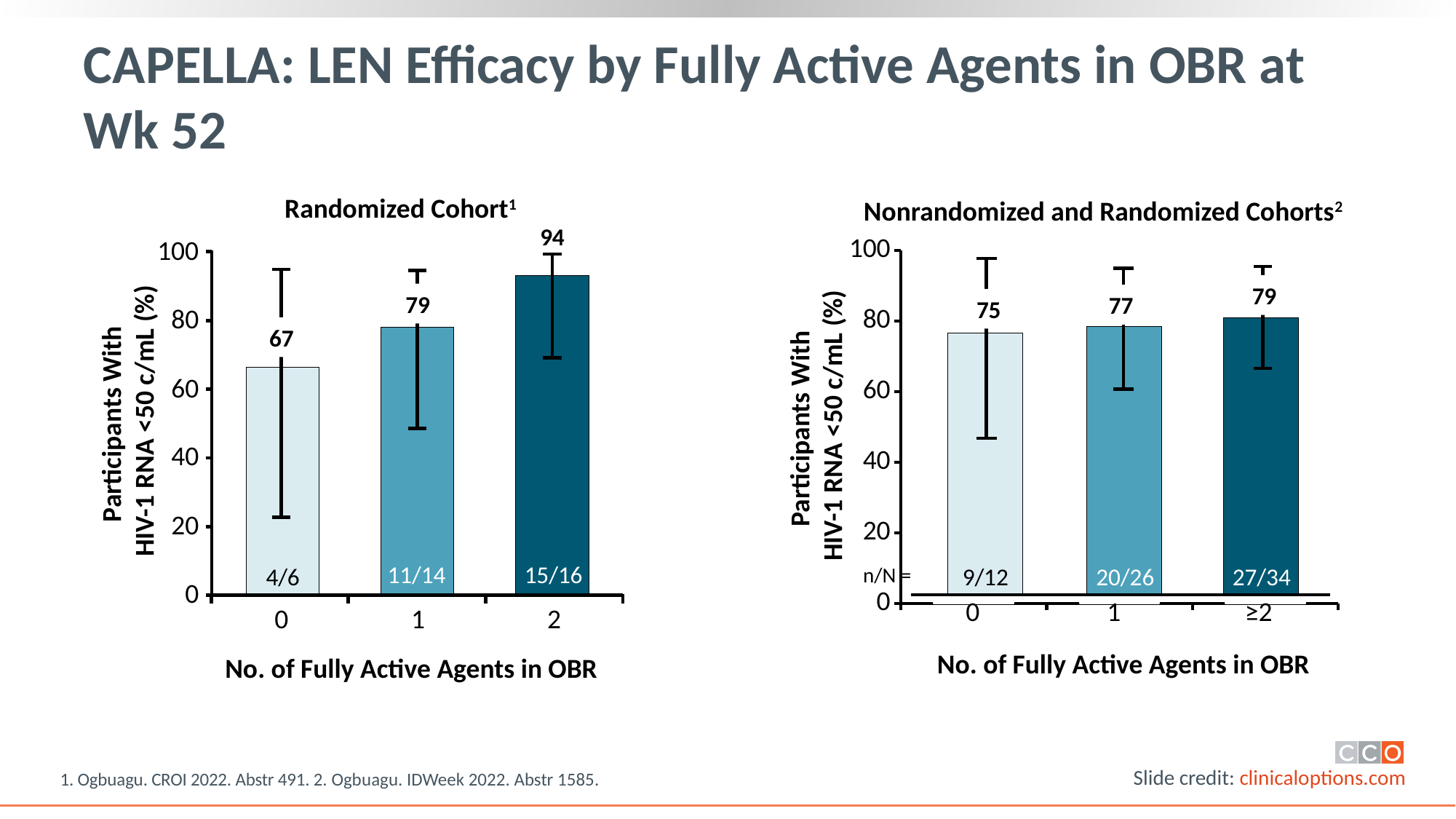
In the Randomized Cohort chart, what percentage of participants with 0 fully active agents in OBR had HIV-1 RNA <50 c/mL? 67 In the Nonrandomized and Randomized Cohorts chart, what is the difference between the values for ≥2 and 0 fully active agents? 4 How many bars are in the Randomized Cohort chart? 3 In the Randomized Cohort chart, do the values rise or fall as the number of fully active agents increases? Rise In the Nonrandomized and Randomized Cohorts chart, which number of fully active agents has the lowest percentage? 0 In the Randomized Cohort chart, what is the difference in percentage between 2 and 0 fully active agents? 27 In the Randomized Cohort chart, which number of fully active agents has the highest percentage? 2 What type of chart is used in the Nonrandomized and Randomized Cohorts panel? Bar chart In the Randomized Cohort chart, what is the value for 2 fully active agents in OBR? 94 Which is larger: the value for 1 fully active agent in the Randomized Cohort chart or the value for 1 fully active agent in the Nonrandomized and Randomized Cohorts chart? Randomized Cohort In the Nonrandomized and Randomized Cohorts chart, what is the value for 1 fully active agent in OBR? 77 In the Nonrandomized and Randomized Cohorts chart, what is the n/N shown for the ≥2 fully active agents bar? 27/34